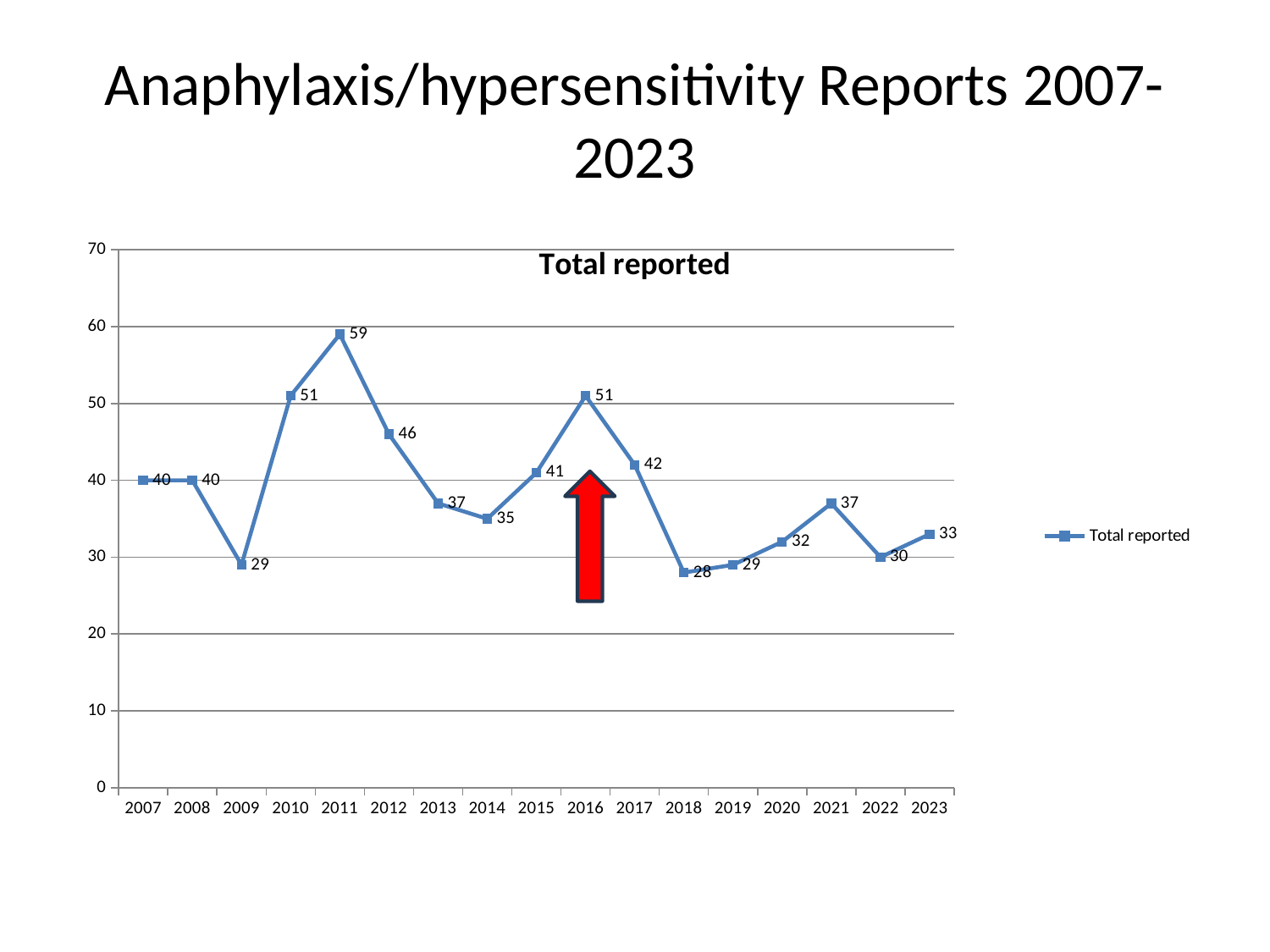
What is the total reported for 2016? 51 What is the difference between the total reported in 2011 and in 2009? 30 Do the values rise or fall from 2016 to 2018? fall How many years are plotted on the x axis? 17 What kind of chart is shown on the slide? line chart Is the value for 2021 greater or less than 40? less Which year has the lowest total reported? 2018 Which year has a larger total reported, 2012 or 2017? 2012 Which year has the highest total reported? 2011 How many series does the legend list? 1 What is the total reported for 2011? 59 What is the total reported for 2018? 28